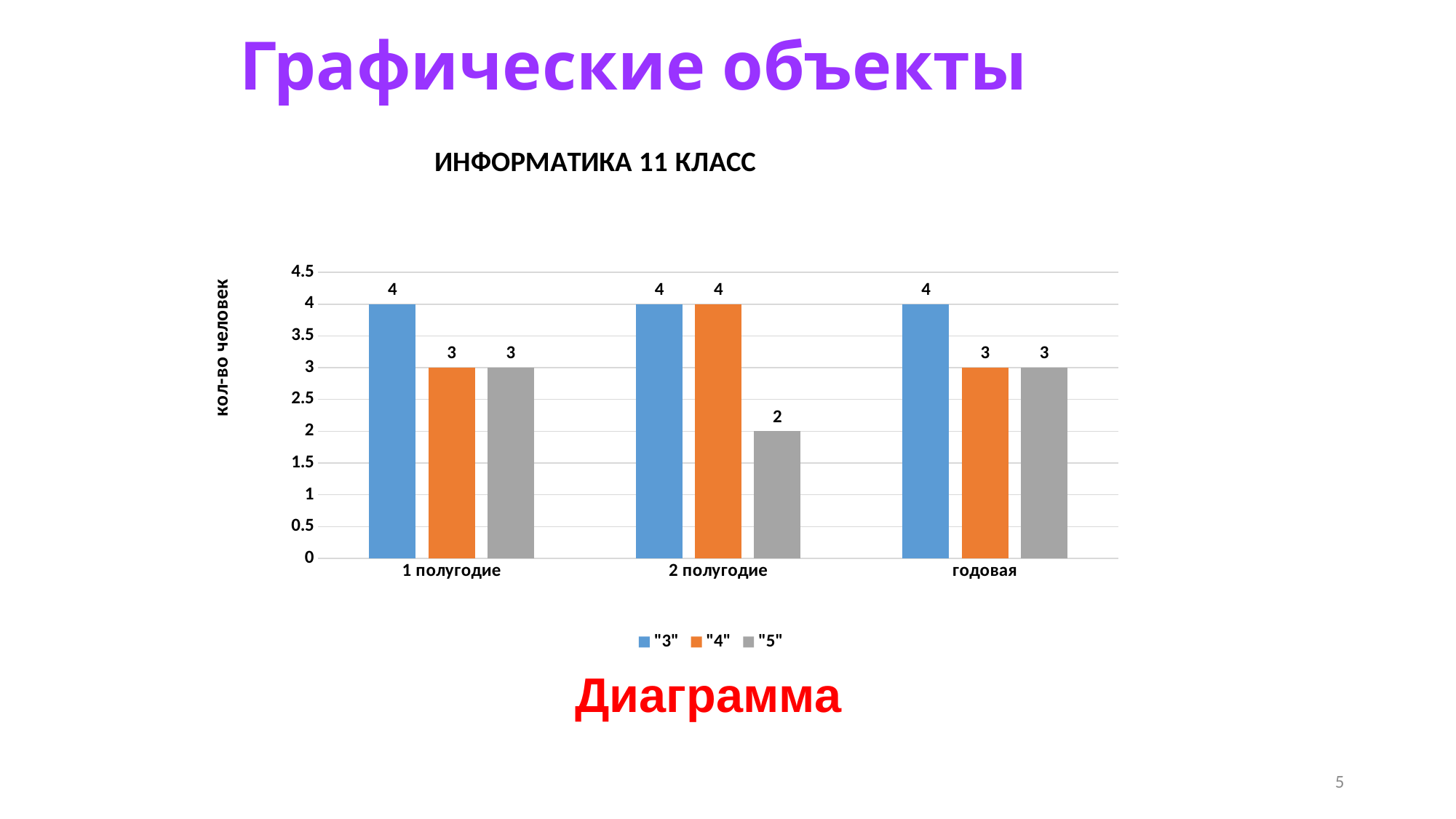
What is the value for series "5" in 2 полугодие? 2 What is the difference between the values for series "3" and series "5" in 2 полугодие? 2 What is the value for series "4" in годовая? 3 What is the value for series "3" in 1 полугодие? 4 What is the title of the chart? ИНФОРМАТИКА 11 КЛАСС How many categories are shown on the x axis? 3 What kind of chart is shown on the slide? bar chart Which series has the lowest value in 2 полугодие? "5" What is the label of the vertical axis? кол-во человек How many series does the legend list? 3 Which series has the highest value in годовая? "3" Which is larger: the value for series "4" in 2 полугодие or the value for series "4" in 1 полугодие? 2 полугодие